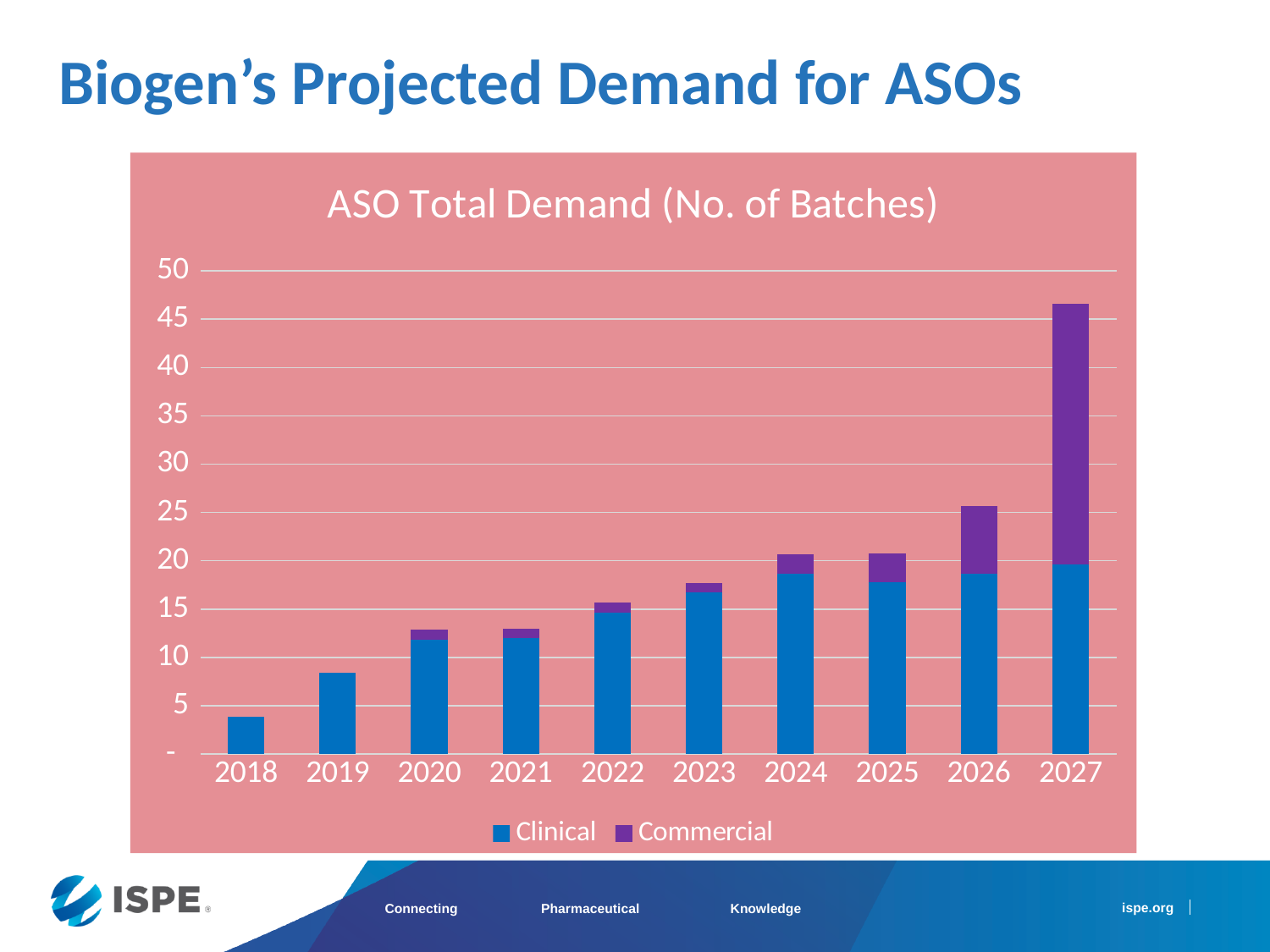
Is the total demand for 2027 greater or less than 40? greater Do the total demand values generally rise or fall from 2018 to 2027? Rise What kind of chart is shown on the slide? Stacked bar chart Which year has the larger total demand, 2026 or 2027? 2027 Which series is shown in purple in the legend? Commercial Which year has the highest total demand? 2027 What is the title of the chart? ASO Total Demand (No. of Batches) Is the total demand for 2018 greater or less than 5? less Which year has the lowest total demand? 2018 Is the total demand for 2023 greater or less than 20? less How many years are shown on the x axis? 10 How many series does the legend list? 2